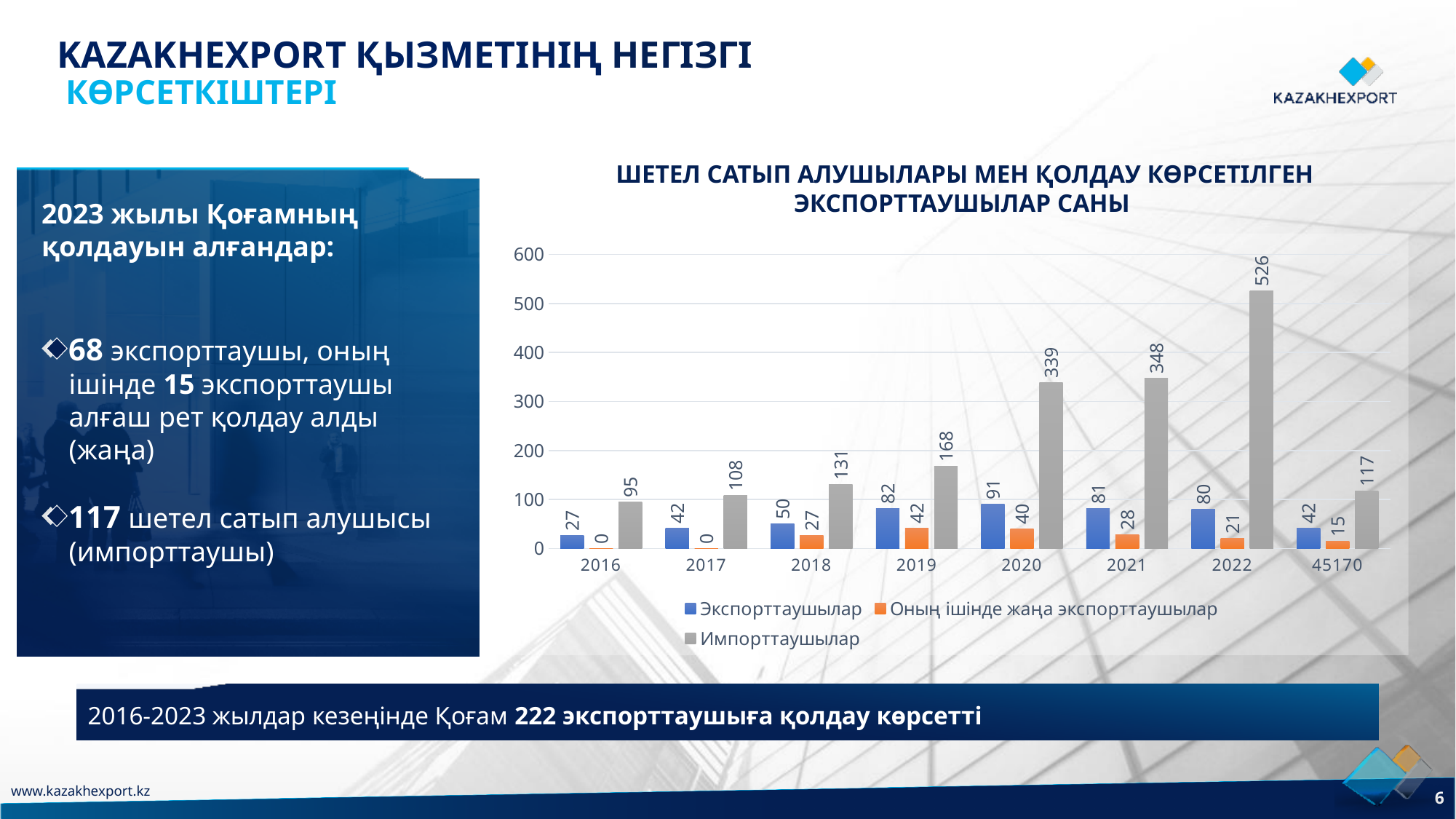
What is the value for Импорттаушылар in 2022? 526 What is the label of the last category on the x axis of the chart? 45170 What is the difference between the Импорттаушылар values for 2022 and 2021? 178 In which year is the value for Импорттаушылар highest? 2022 What is the value for Оның ішінде жаңа экспорттаушылар in 2019? 42 What is the value for Экспорттаушылар in 2020? 91 Is the value for Импорттаушылар in 2020 greater or less than 300? greater How many categories are shown on the x axis of the chart? 8 In which year is the value for Экспорттаушылар lowest? 2016 What type of chart is shown on the slide? bar chart How many series does the chart legend list? 3 Which is larger: the Экспорттаушылар value for 2019 or for 2021? 2019